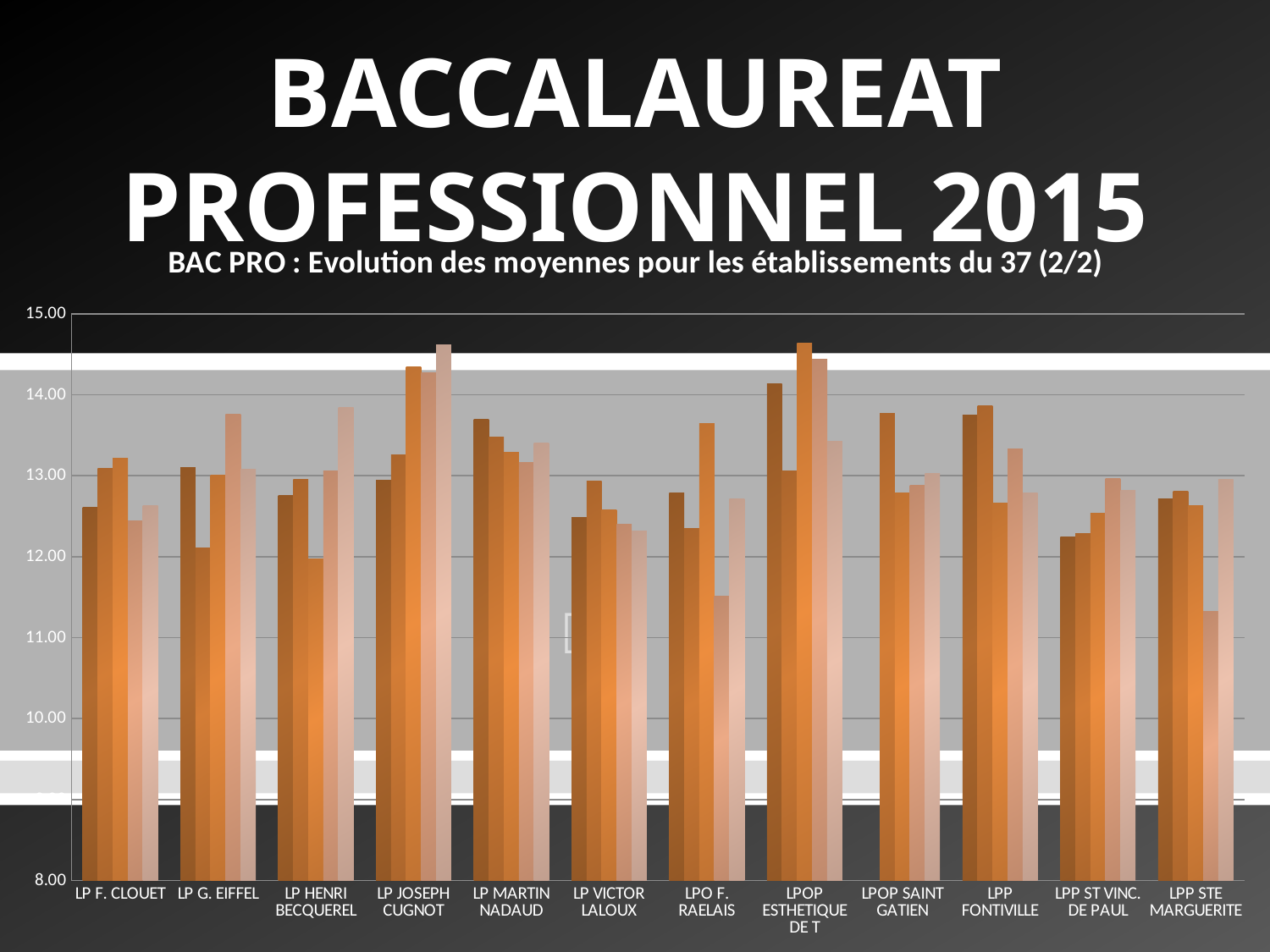
What is the subtitle of the chart? BAC PRO : Evolution des moyennes pour les établissements du 37 (2/2) Is the value of the leftmost bar for LPOP ESTHETIQUE DE T greater or less than 14.00? greater For LP JOSEPH CUGNOT, which is larger: the leftmost bar or the second bar? the second bar Is the value of the second bar for LP JOSEPH CUGNOT greater or less than 14.00? less What is the lowest value shown on the vertical axis? 8.00 Which establishment has a taller tallest bar: LP VICTOR LALOUX or LPOP ESTHETIQUE DE T? LPOP ESTHETIQUE DE T What kind of chart is shown on the slide? bar chart How many establishments (categories) are shown along the x axis? 12 Is the value of the fourth bar for LPP STE MARGUERITE greater or less than 12.00? less